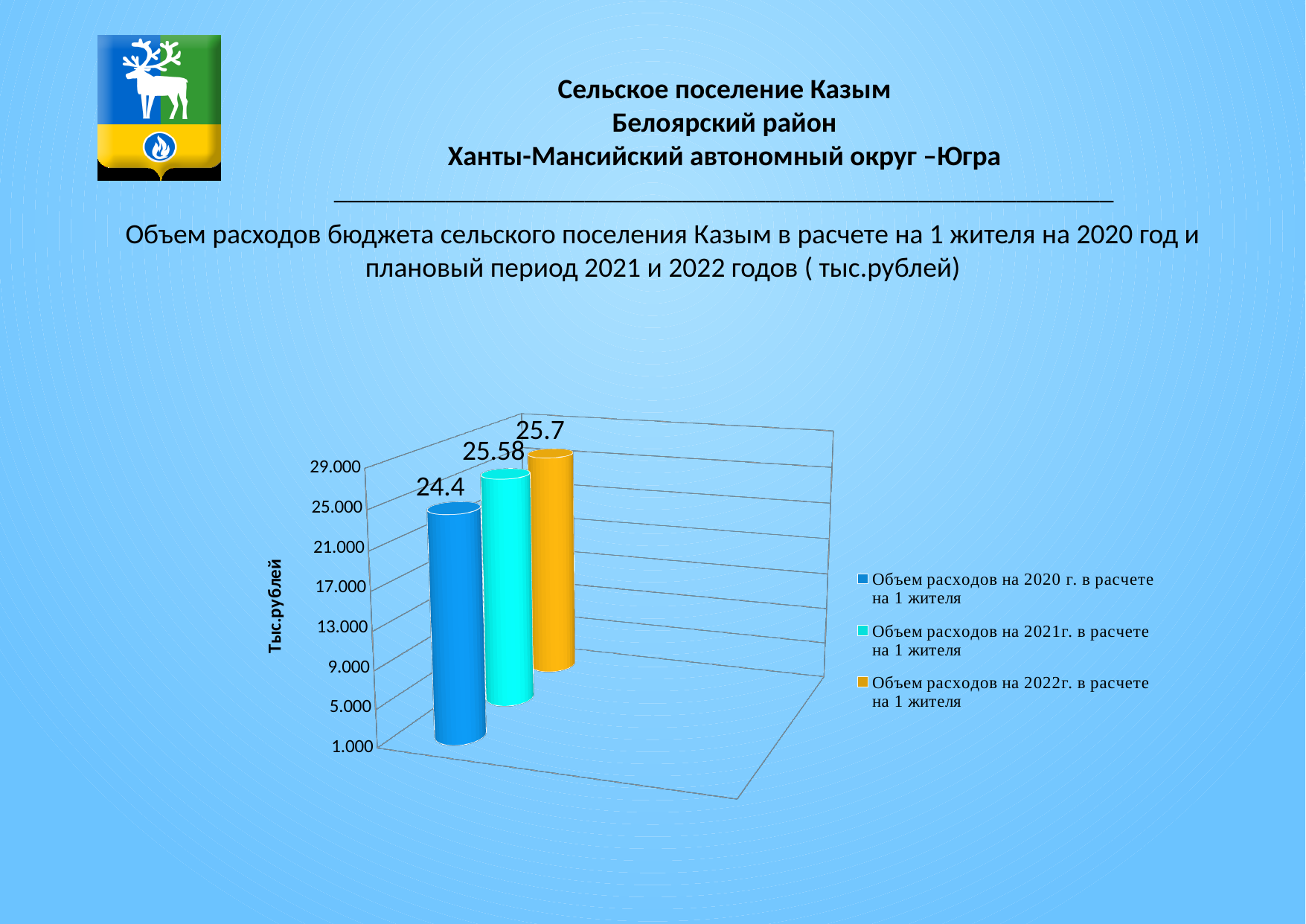
What is the difference between the 2022 value and the 2020 value? 1.3 What kind of chart is shown on the slide? bar chart What is the value for 'Объем расходов на 2020 г. в расчете на 1 жителя'? 24.4 Which year has the lowest expenditure per resident? 2020 Which is larger, the value for 2021 or the value for 2022? 2022 What is the value for 'Объем расходов на 2021г. в расчете на 1 жителя'? 25.58 What is the label of the vertical axis? Тыс.рублей Which year has the highest expenditure per resident? 2022 What is the value for 'Объем расходов на 2022г. в расчете на 1 жителя'? 25.7 What is the difference between the 2021 value and the 2020 value? 1.18 How many series does the legend list? 3 Is the value for 2020 greater or less than 21.000? greater